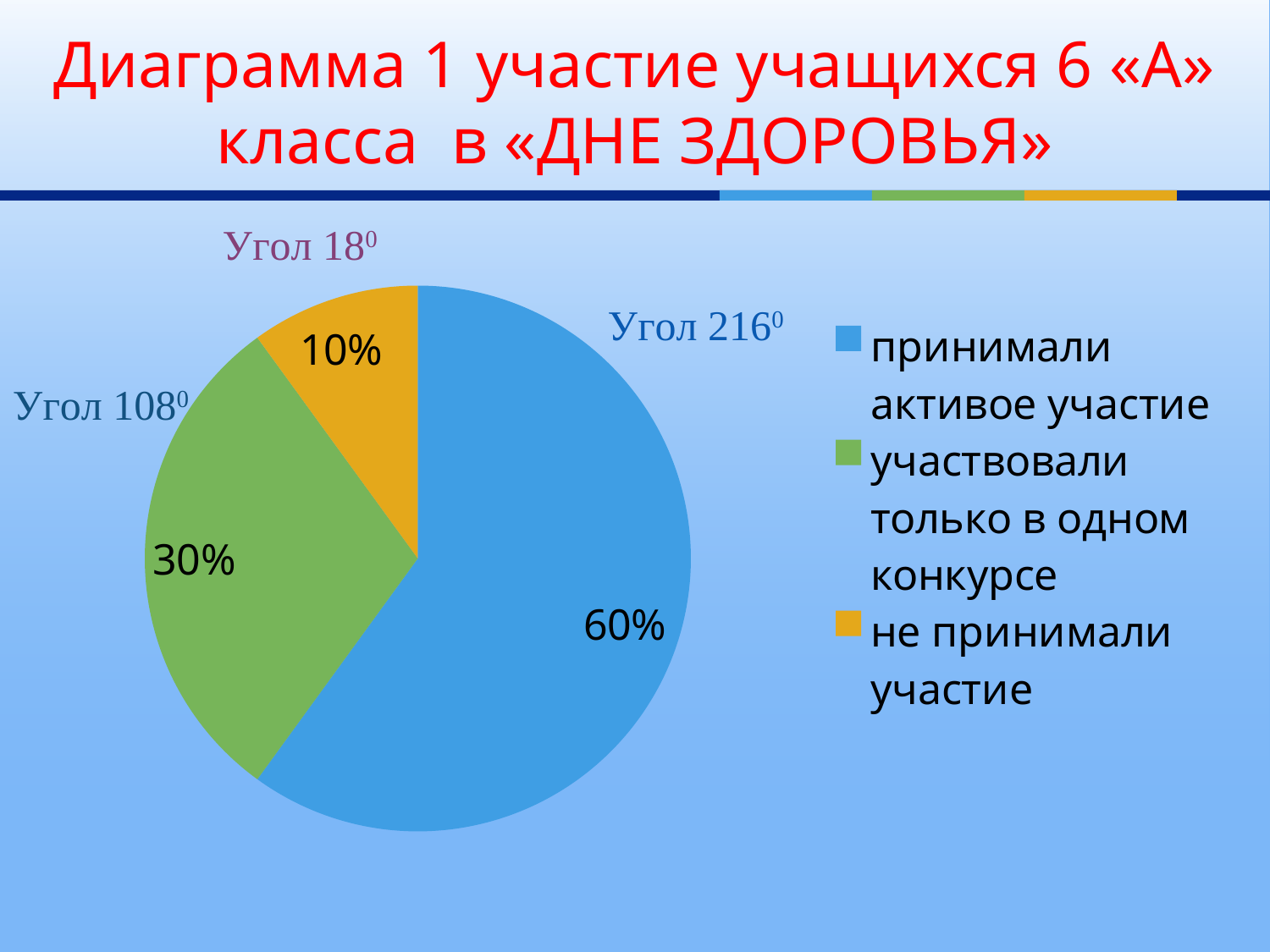
Which is larger: the slice for "участвовали только в одном конкурсе" or the slice for "не принимали участие"? участвовали только в одном конкурсе What percentage of the pie is labelled for "не принимали участие"? 10% Which category has the smallest slice of the pie? не принимали участие What is the difference in percentage points between "принимали активное участие" and "участвовали только в одном конкурсе"? 30 What colour is the slice for "не принимали участие"? orange What angle is annotated next to the blue slice? Угол 216⁰ What percentage of the pie is labelled for "принимали активное участие"? 60% Which category has the largest slice of the pie? принимали активное участие How many entries does the legend list? 3 How many slices does the pie chart have? 3 What kind of chart is shown on the slide? pie chart What percentage of the pie is labelled for "участвовали только в одном конкурсе"? 30%